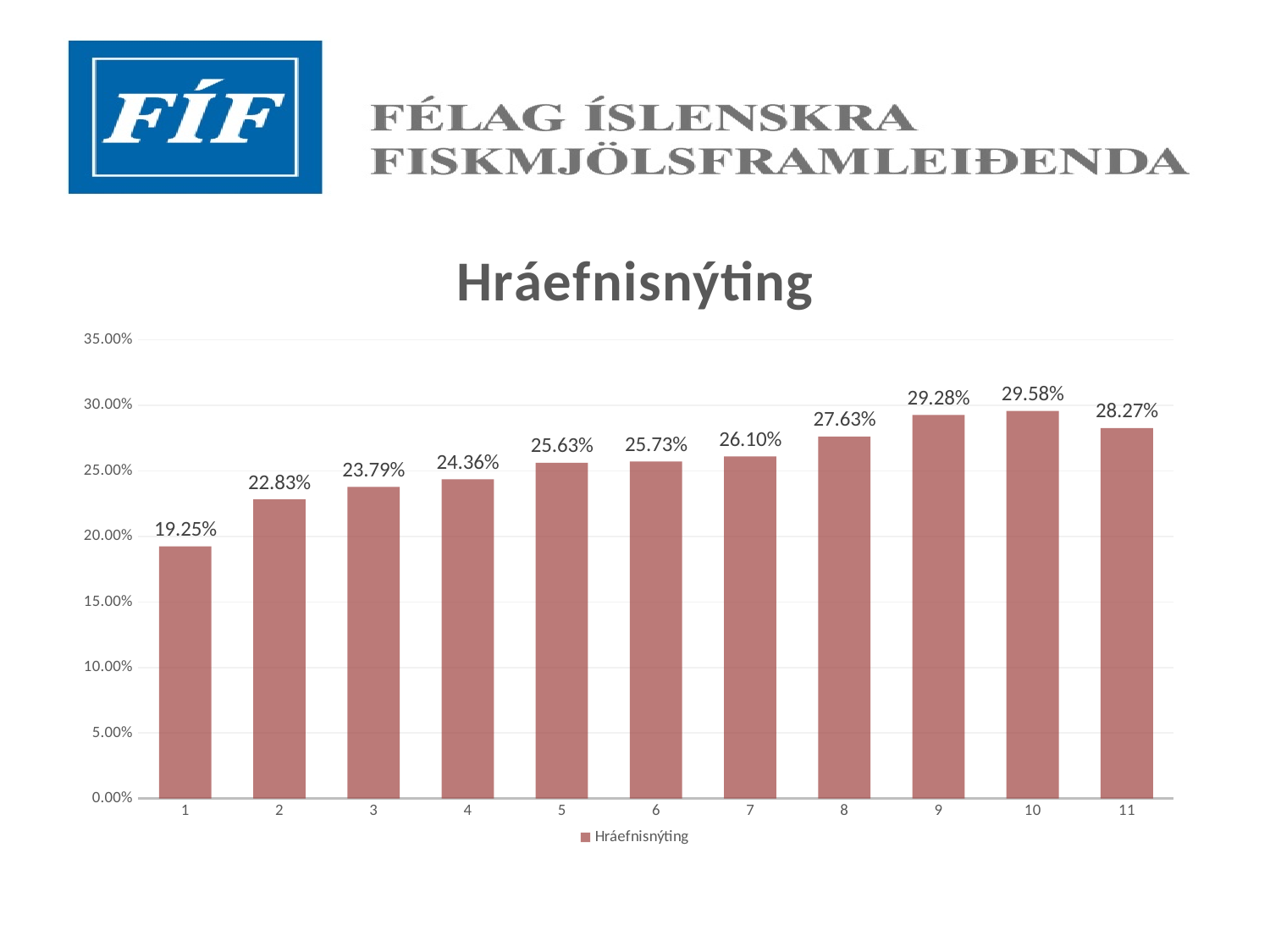
What is the value for category 11? 28.27% Which category has the highest value? 10 What is the title of the chart? Hráefnisnýting How many categories are shown on the x axis? 11 What is the value for category 8? 27.63% What kind of chart is shown on the slide? bar chart Which is larger, the value for category 4 or the value for category 7? 7 What is the value for category 1? 19.25% Is the value for category 3 greater or less than 25.00%? less Which category has the lowest value? 1 What is the difference between the values for category 11 and category 10? 1.31% What is the difference between the values for category 10 and category 1? 10.33%